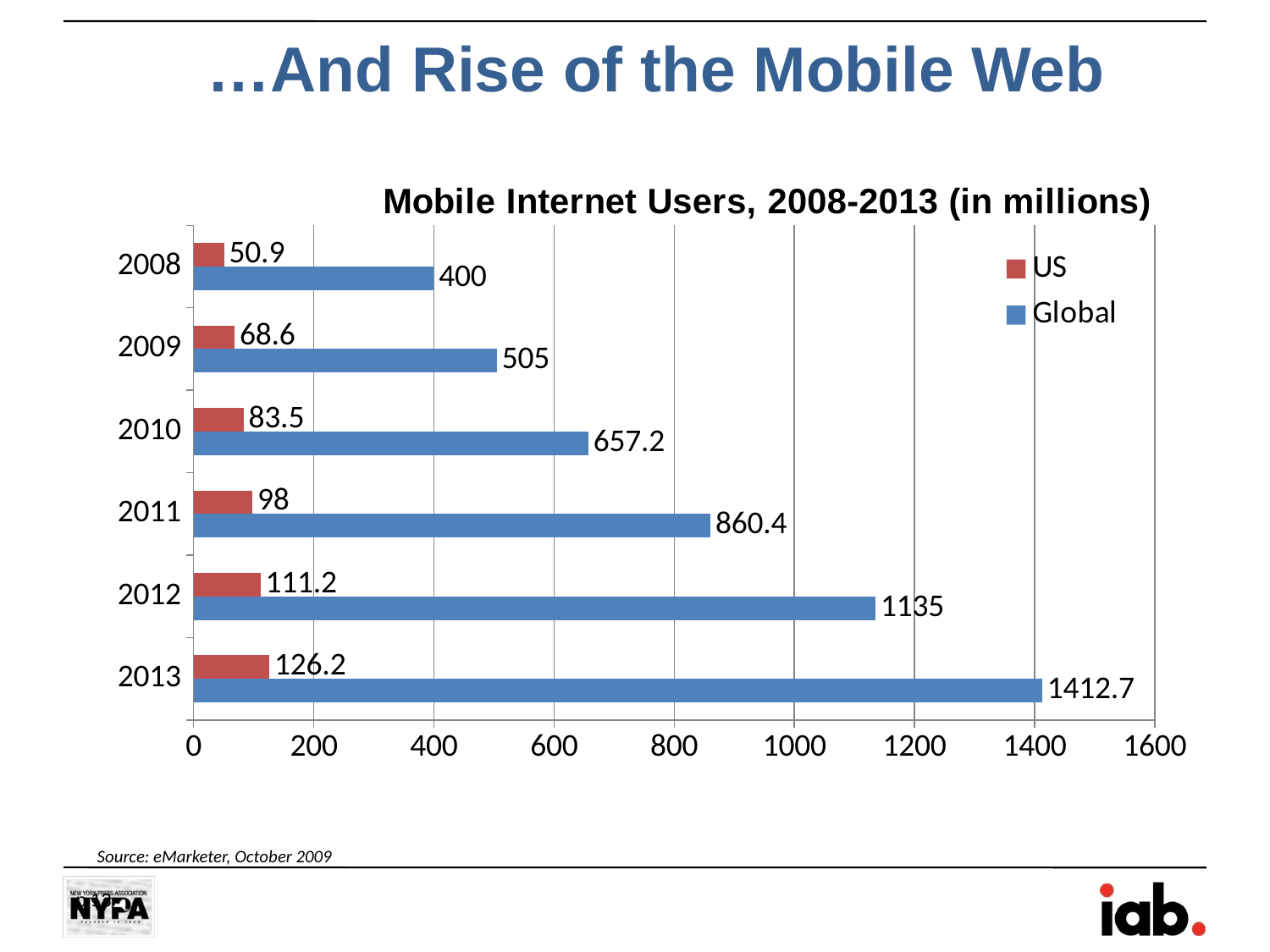
How many series does the legend list? 2 What kind of chart is shown on the slide? Bar chart What is the difference between the Global values for 2013 and 2012? 277.7 Which year has the highest Global value? 2013 Is the Global value for 2011 greater or less than 800? greater What is the difference between the US values for 2011 and 2010? 14.5 How many years are shown on the chart? 6 What is the Global value for 2010? 657.2 Which is larger, the Global value for 2009 or the Global value for 2010? 2010 What is the US value for 2012? 111.2 What is the Global value for 2013? 1412.7 Which year has the lowest US value? 2008